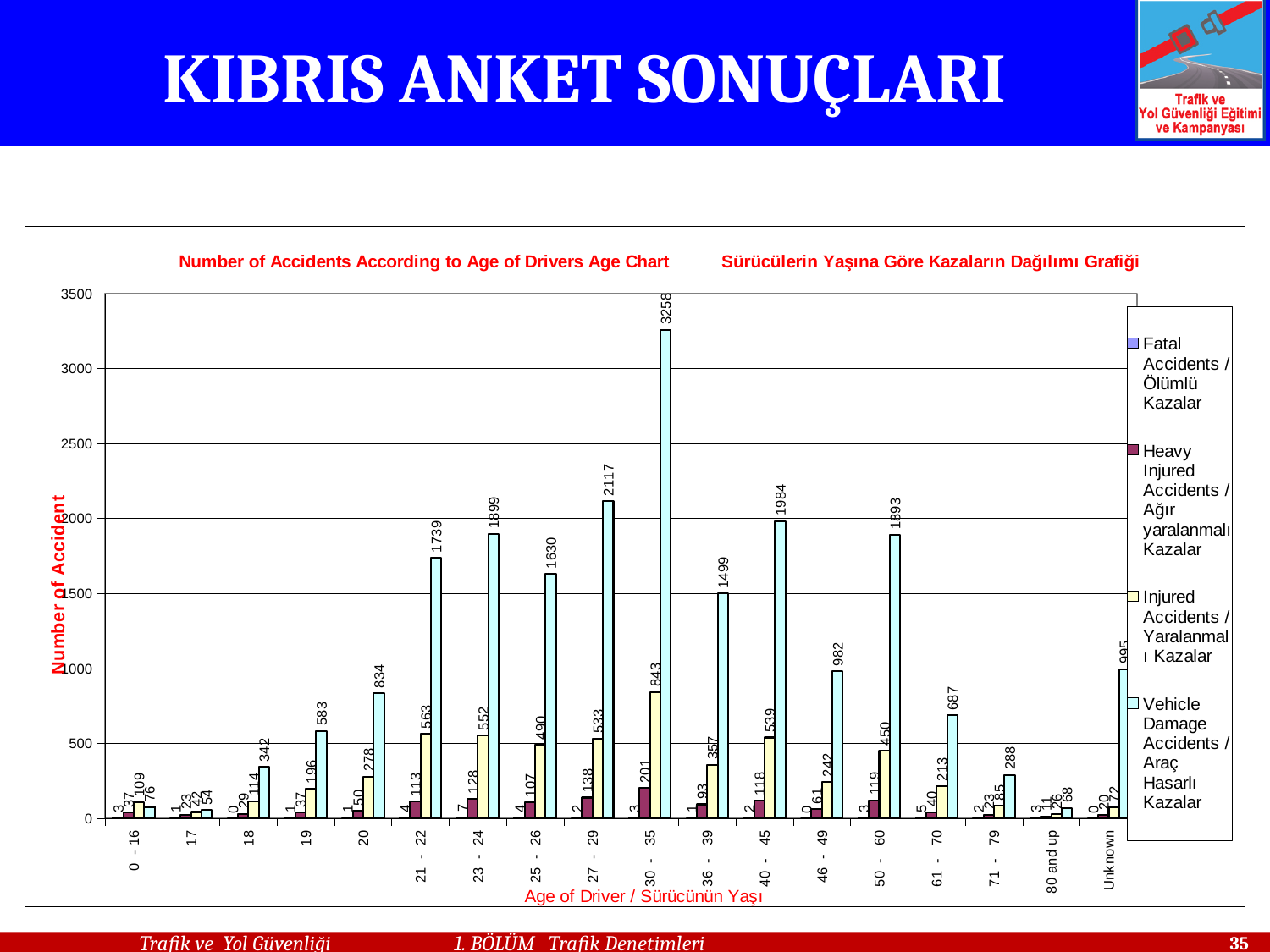
Do the Vehicle Damage Accidents values rise or fall from age 17 to age 20? rise How many series does the legend list? 4 What is the number of Injured Accidents for drivers aged 21 - 22? 563 Which age category has the lowest number of Vehicle Damage Accidents? 17 Which age category has the highest number of Vehicle Damage Accidents? 30 - 35 Is the number of Vehicle Damage Accidents for drivers aged 61 - 70 greater or less than 500? greater What is the difference in Vehicle Damage Accidents between the 30 - 35 and 27 - 29 age groups? 1141 What is the number of Vehicle Damage Accidents for the Unknown age category? 995 Which age group has more Vehicle Damage Accidents, 40 - 45 or 50 - 60? 40 - 45 How many age categories are shown on the x axis? 18 What is the number of Vehicle Damage Accidents for drivers aged 30 - 35? 3258 What type of chart is shown on the slide? bar chart